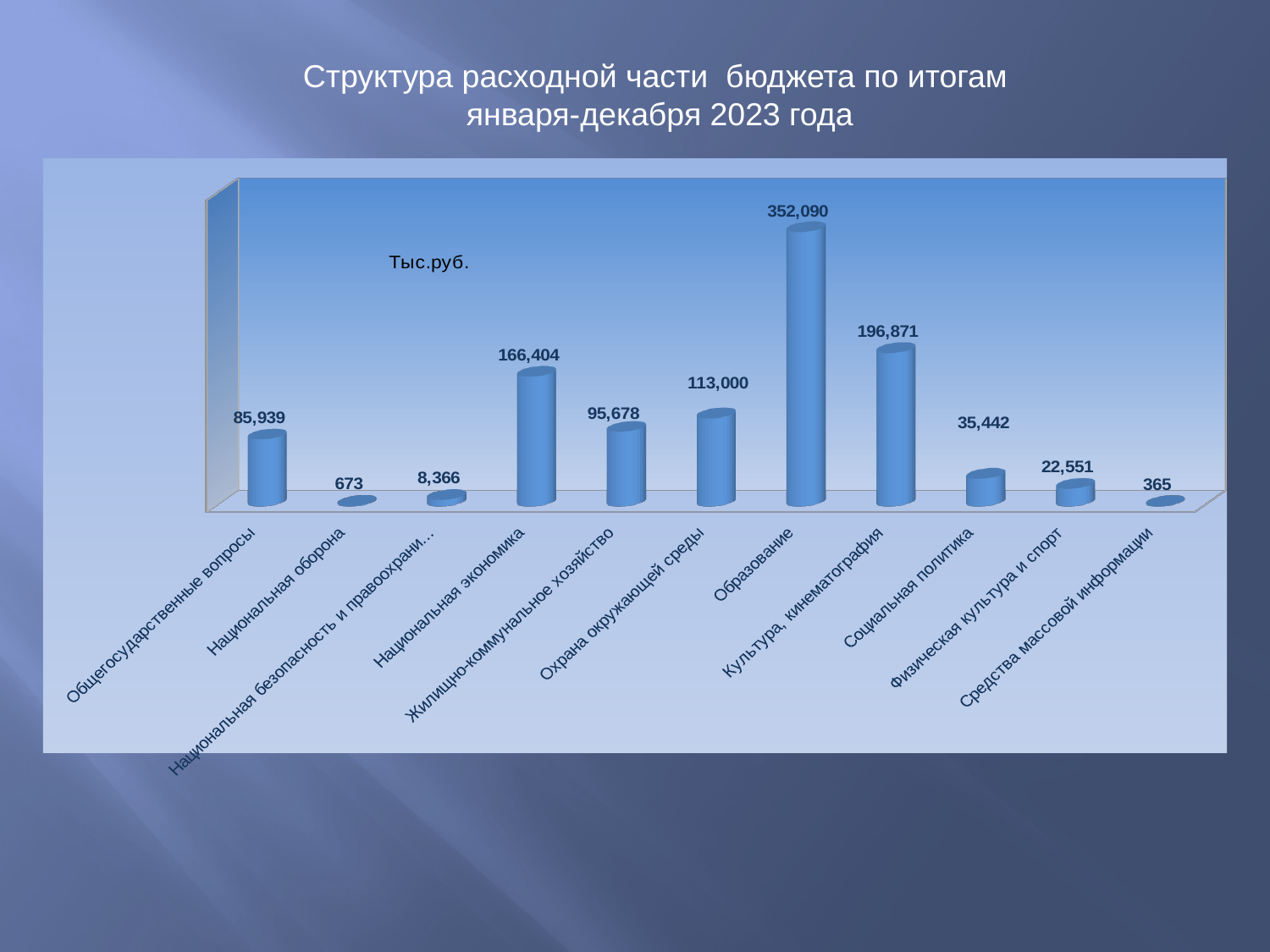
How many categories are shown in the chart? 11 What is the difference between the values for Образование and Культура, кинематография? 155,219 What kind of chart is shown on the slide? Bar chart What is the value for Средства массовой информации? 365 What is the value for Социальная политика? 35,442 Which category has the highest value? Образование What is the value for Образование? 352,090 What unit is indicated on the chart? Тыс.руб. Which category has the lowest value? Средства массовой информации Which is larger, the value for Охрана окружающей среды or the value for Общегосударственные вопросы? Охрана окружающей среды What is the difference between the values for Национальная экономика and Жилищно-коммунальное хозяйство? 70,726 What is the value for Национальная экономика? 166,404